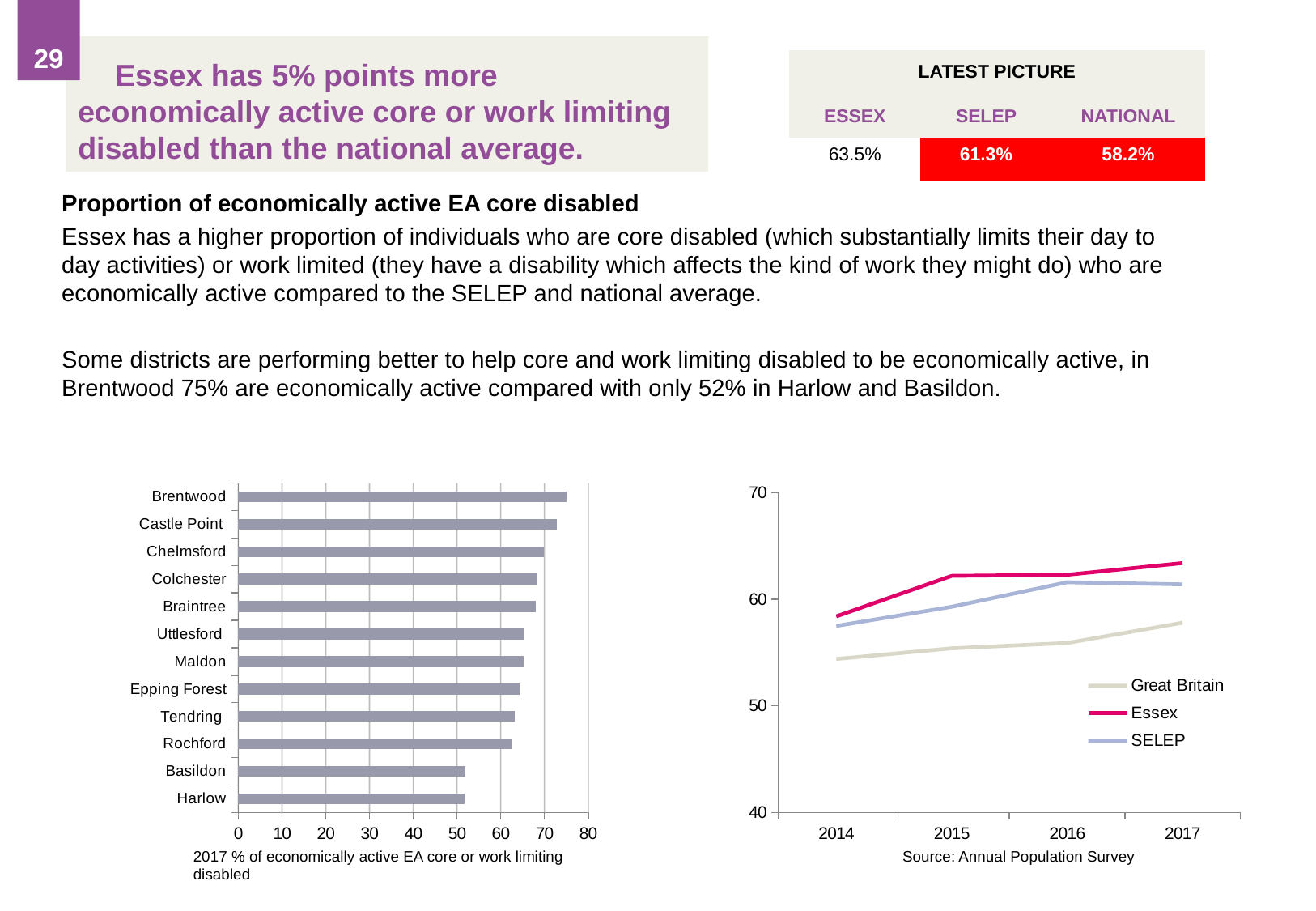
On the left bar chart, is the value for Brentwood greater or less than 70? greater On the right line chart, which is larger in 2017, Essex or Great Britain? Essex On the left bar chart, which district has the lowest value? Harlow On the left bar chart, is the value for Colchester greater or less than 60? greater On the left bar chart, is the value for Harlow greater or less than 60? less On the left bar chart, which is larger, the value for Castle Point or the value for Basildon? Castle Point What kind of chart is the left chart showing districts? bar chart On the left bar chart, which district has the highest value? Brentwood On the right line chart, does the Essex line rise or fall from 2014 to 2017? rise How many districts are shown on the left bar chart? 12 How many series does the legend of the right line chart list? 3